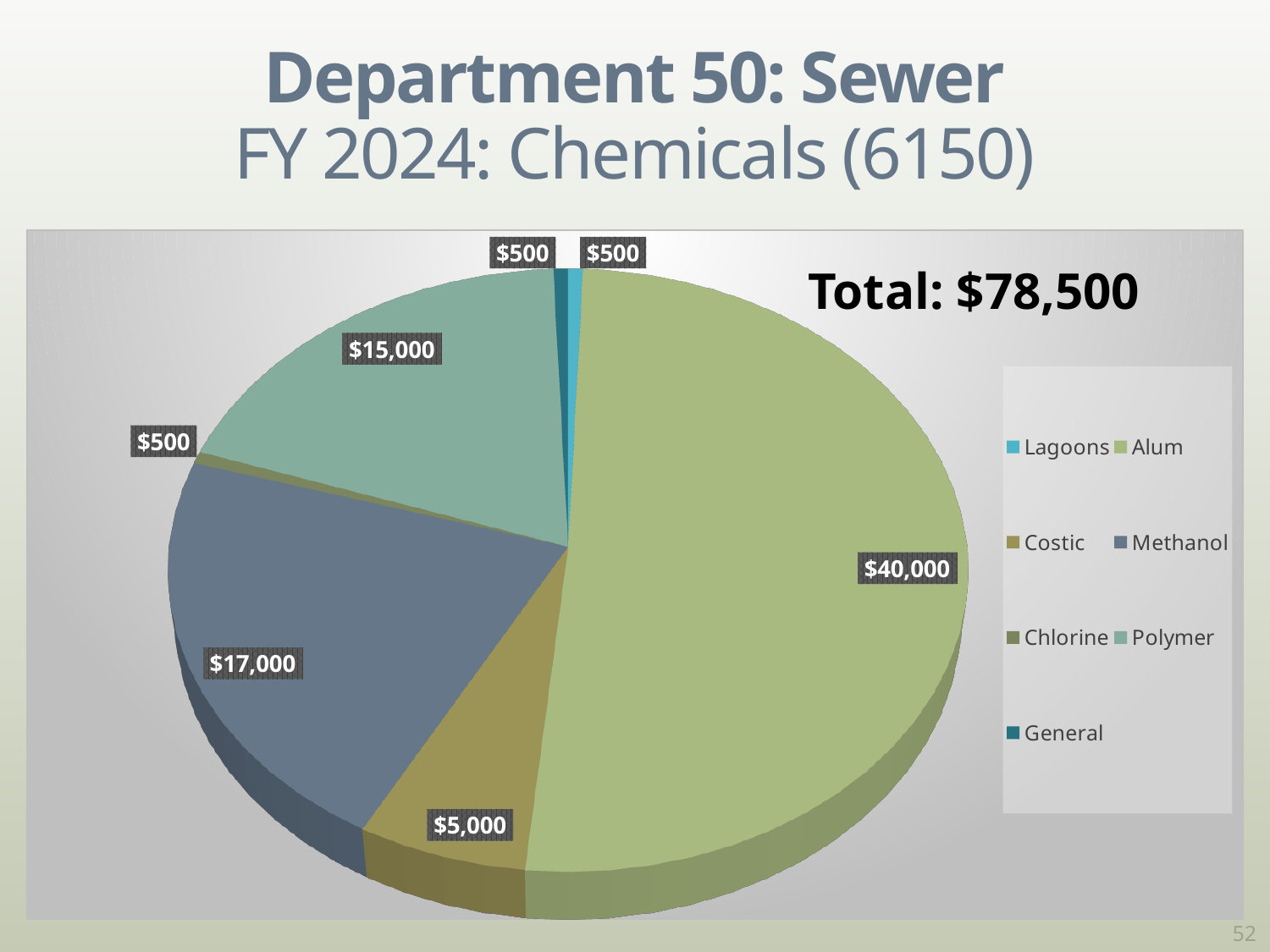
What is the value for Methanol? $17,000 How many categories does the legend list? 7 What is the value for Costic? $5,000 Which category has the largest slice of the pie? Alum Which is larger, Methanol or Polymer? Methanol What is the difference between the Alum and Methanol values? $23,000 What is the difference between the Methanol and Polymer values? $2,000 What kind of chart is shown on the slide? Pie chart What is the value for Alum? $40,000 What is the value for Polymer? $15,000 What total is printed on the chart? $78,500 How many categories have a value of $500? 3